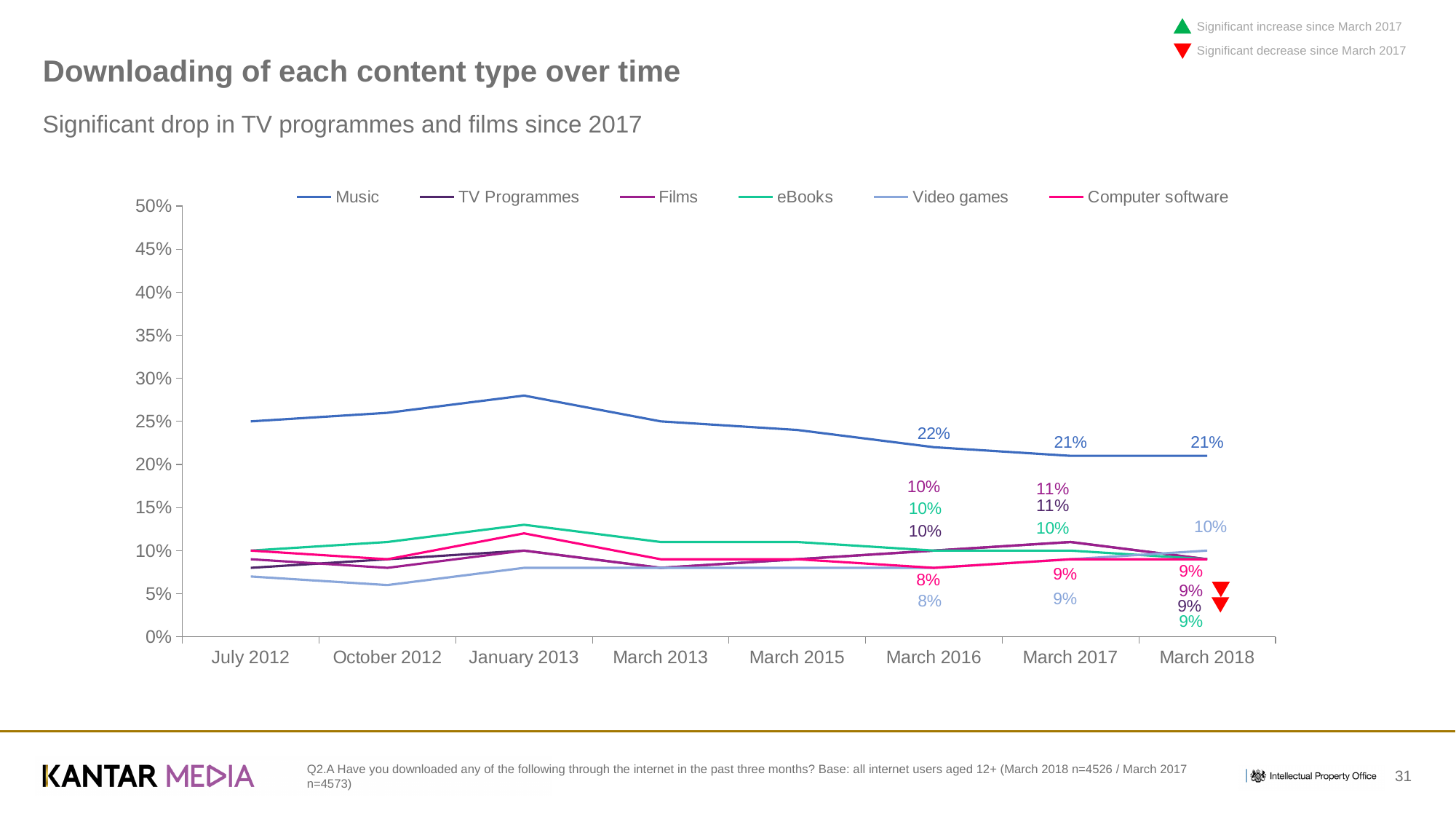
How many series does the legend list? 6 What is the value for Computer software in March 2016? 8% What is the value for Music in March 2018? 21% What kind of chart is shown on the slide? line chart Is the value for Music in January 2013 greater or less than 25%? greater By how many percentage points did Music fall between March 2016 and March 2018? 1 percentage point Which series has the highest value in March 2018? Music How many time points are shown along the x axis? 8 What is the value for Music in March 2016? 22% Which is larger in March 2016: Music or Video games? Music What is the value for Video games in March 2018? 10% What is the value for eBooks in March 2017? 10%